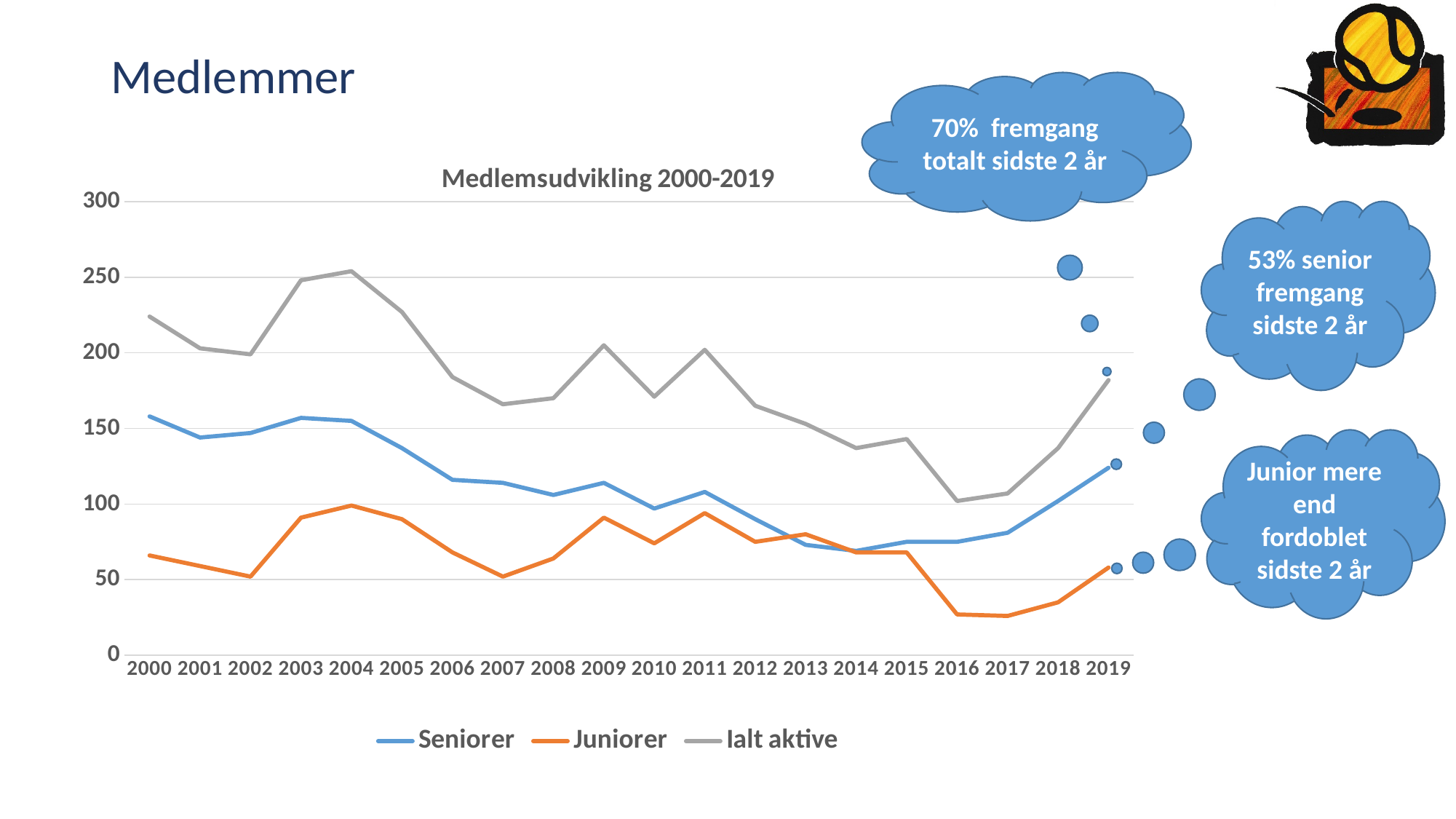
Which colour is used for the Juniorer series? orange Is the value for Juniorer in 2016 greater or less than 50? less In 2000, which series has the larger value, Seniorer or Juniorer? Seniorer Is the value for Seniorer in 2019 greater or less than 100? greater How many years are plotted along the x axis? 20 Is the value for Ialt aktive in 2016 greater or less than 150? less How many series does the legend list? 3 For Ialt aktive, which year has the larger value, 2000 or 2019? 2000 Do the Juniorer values rise or fall from 2017 to 2019? rise What is the title of the chart? Medlemsudvikling 2000-2019 What kind of chart is shown on the slide? line chart